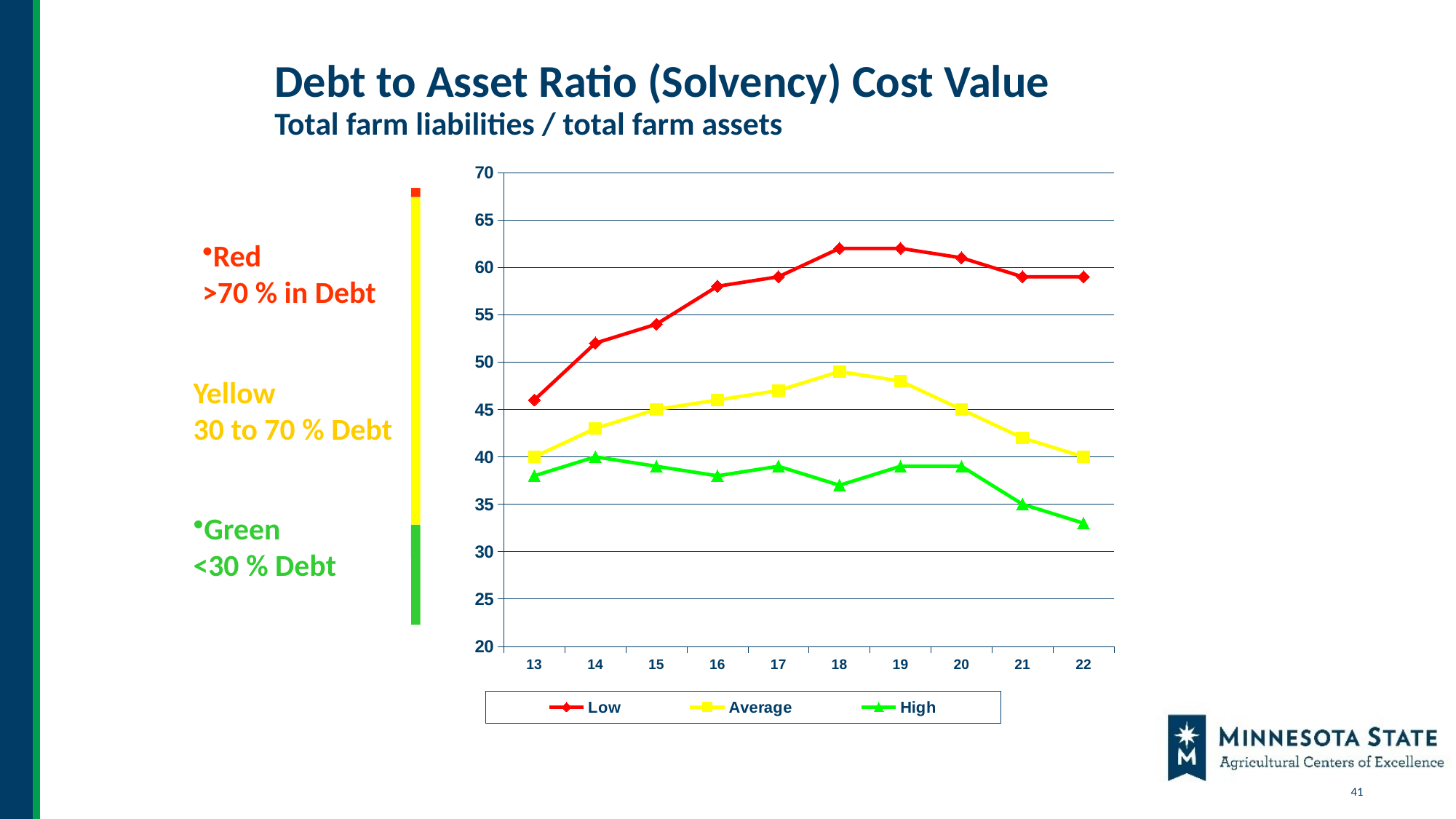
What kind of chart is shown on the slide? Line chart In which year is the High series at its lowest value? 22 Is the value of the Low series in year 16 greater or less than 55? greater In which year is the Low series at its lowest value? 13 How many series does the chart legend list? 3 Which series has the larger value in year 18, Low or High? Low What is the value of the High series in year 21? 35 Is the value of the High series in year 22 greater or less than 35? less Is the value of the Low series in year 18 greater or less than 60? greater How many years are plotted along the x axis of the chart? 10 What is the value of the Average series in year 22? 40 What is the value of the Average series in year 13? 40